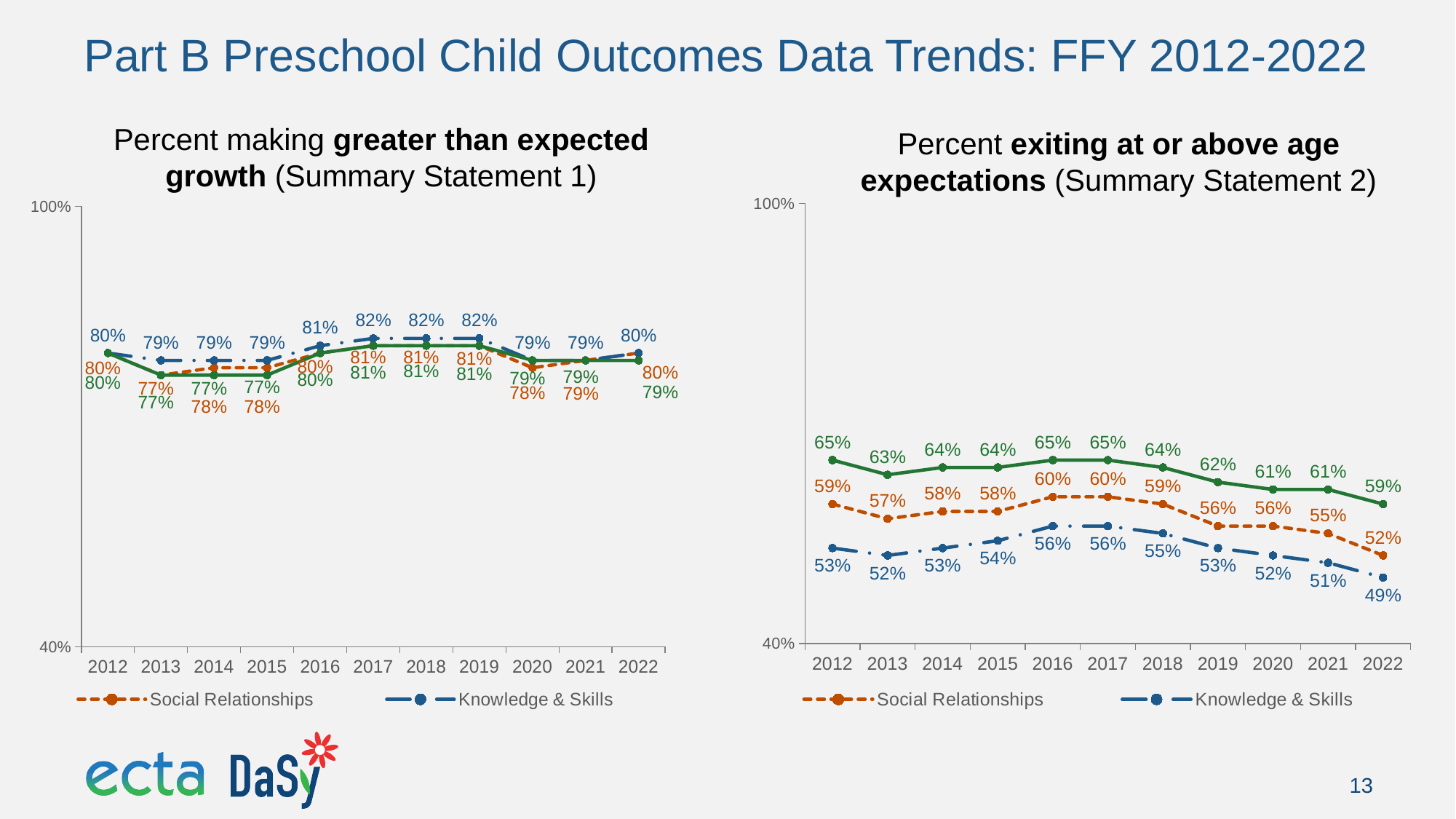
What type of chart is used on this slide for the Summary Statement 1 and Summary Statement 2 data? Line chart In the 'Percent making greater than expected growth (Summary Statement 1)' chart, what is the highest value reached by the Knowledge & Skills series? 82% In the 'Percent exiting at or above age expectations (Summary Statement 2)' chart, in which year is the Knowledge & Skills value lowest? 2022 How many series does the legend of the 'Percent making greater than expected growth (Summary Statement 1)' chart list? 2 In the 'Percent making greater than expected growth (Summary Statement 1)' chart, what is the Knowledge & Skills value for 2016? 81% In the 'Percent exiting at or above age expectations (Summary Statement 2)' chart, what is the Social Relationships value for 2016? 60% What is the lowest value shown on the y axis of the 'Percent exiting at or above age expectations (Summary Statement 2)' chart? 40% In the 'Percent exiting at or above age expectations (Summary Statement 2)' chart, what is the Knowledge & Skills value for 2022? 49% In the 'Percent exiting at or above age expectations (Summary Statement 2)' chart, by how many percentage points did Social Relationships fall from 2012 to 2022? 7 percentage points In the 'Percent exiting at or above age expectations (Summary Statement 2)' chart, does the Knowledge & Skills series rise or fall from 2018 to 2022? Fall How many years are shown on the x axis of the 'Percent exiting at or above age expectations (Summary Statement 2)' chart? 11 In the 'Percent exiting at or above age expectations (Summary Statement 2)' chart, which series has the higher value in 2017: Social Relationships or Knowledge & Skills? Social Relationships